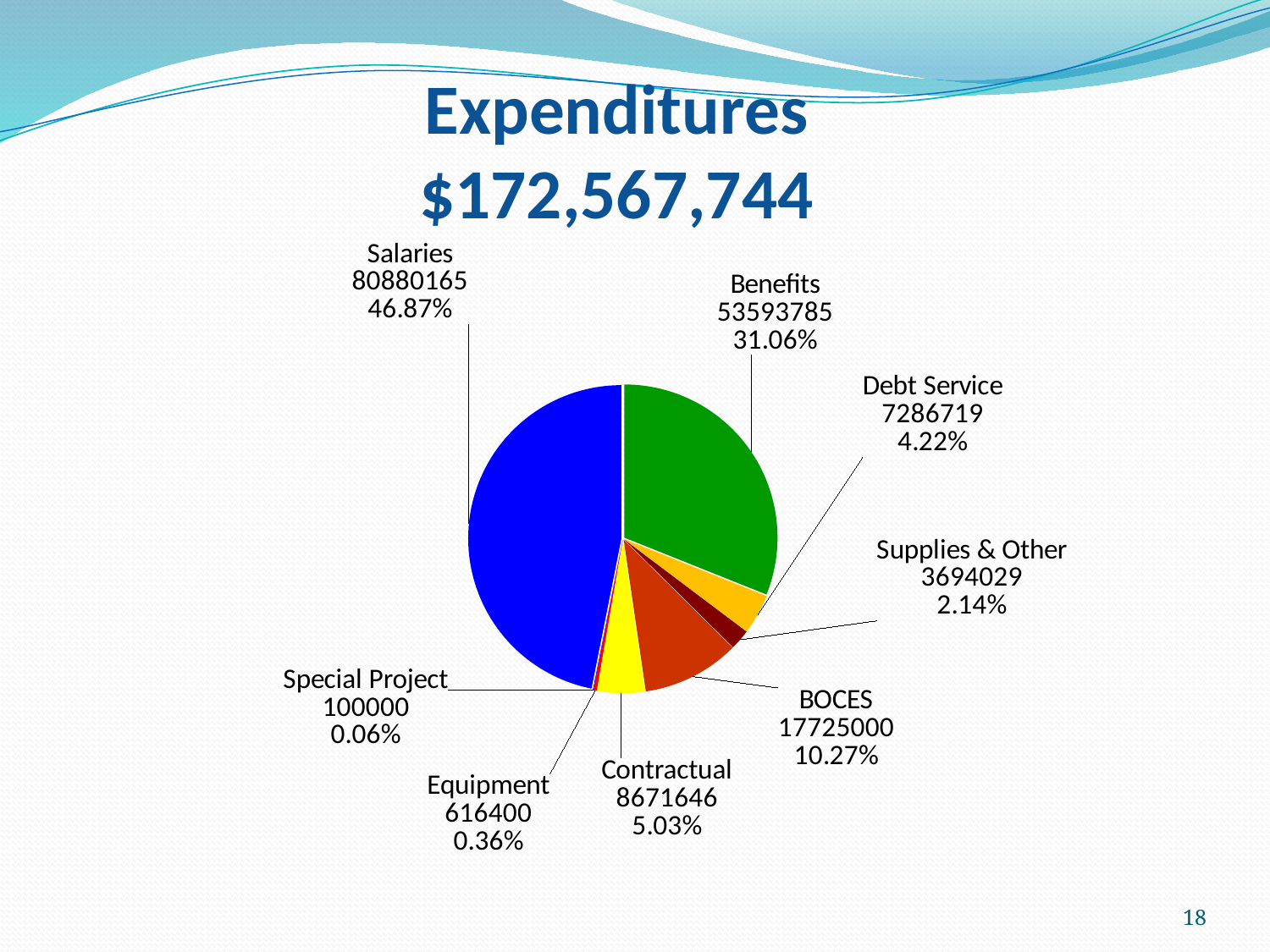
What is the difference between the Benefits value and the Debt Service value? 46307066 What share of the pie does Supplies & Other represent? 2.14% What is the value for Salaries? 80880165 Which category has the smallest slice of the pie? Special Project Which is larger, Contractual or Debt Service? Contractual What total amount is shown in the chart title? $172,567,744 What kind of chart is shown on the slide? Pie chart What percentage share does Benefits have? 31.06% What is the value for Equipment? 616400 How many categories are shown in the pie chart? 8 What is the value for BOCES? 17725000 Which category has the largest slice of the pie? Salaries